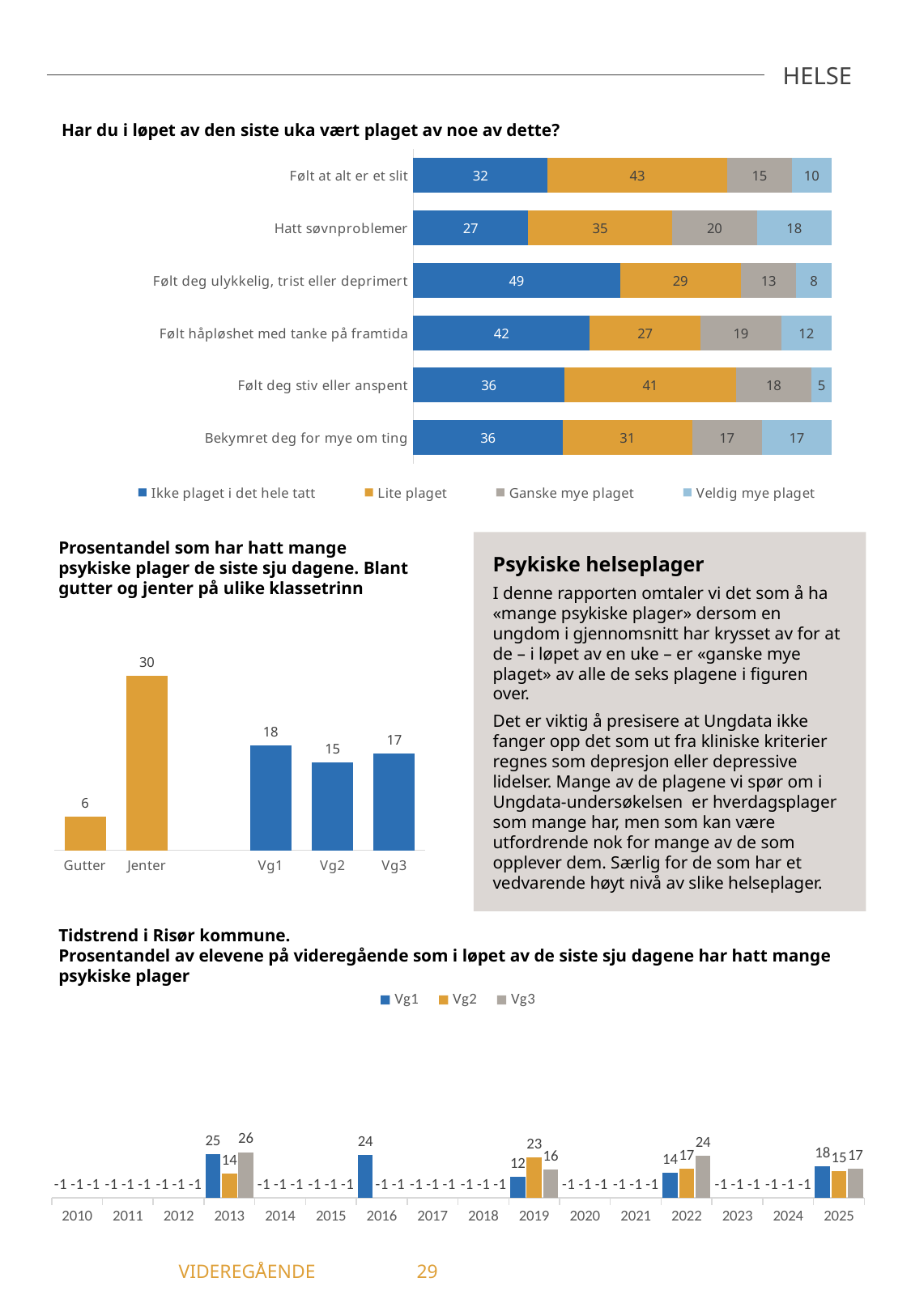
In the bottom chart 'Tidstrend i Risør kommune', which is larger in 2019: Vg1 or Vg2? Vg2 In the bottom chart 'Tidstrend i Risør kommune', what is the value for Vg3 in 2022? 24 In the top chart 'Har du i løpet av den siste uka vært plaget av noe av dette?', what is the difference between the 'Lite plaget' values for 'Følt at alt er et slit' and 'Hatt søvnproblemer'? 8 In the top chart 'Har du i løpet av den siste uka vært plaget av noe av dette?', how many series does the legend list? 4 In the middle-left chart 'Prosentandel som har hatt mange psykiske plager de siste sju dagene', what is the difference between Vg1 and Vg2? 3 In the top chart 'Har du i løpet av den siste uka vært plaget av noe av dette?', what is the value for 'Ikke plaget i det hele tatt' for 'Hatt søvnproblemer'? 27 What kind of chart is the bottom chart 'Tidstrend i Risør kommune'? Bar chart In the top chart 'Har du i løpet av den siste uka vært plaget av noe av dette?', which category has the highest value for 'Ikke plaget i det hele tatt'? Følt deg ulykkelig, trist eller deprimert In the middle-left chart 'Prosentandel som har hatt mange psykiske plager de siste sju dagene', what is the value for Jenter? 30 In the top chart 'Har du i løpet av den siste uka vært plaget av noe av dette?', what is the value for 'Veldig mye plaget' for 'Følt deg stiv eller anspent'? 5 In the middle-left chart 'Prosentandel som har hatt mange psykiske plager de siste sju dagene', which category has the lowest value? Gutter In the middle-left chart 'Prosentandel som har hatt mange psykiske plager de siste sju dagene', how many categories are shown? 5